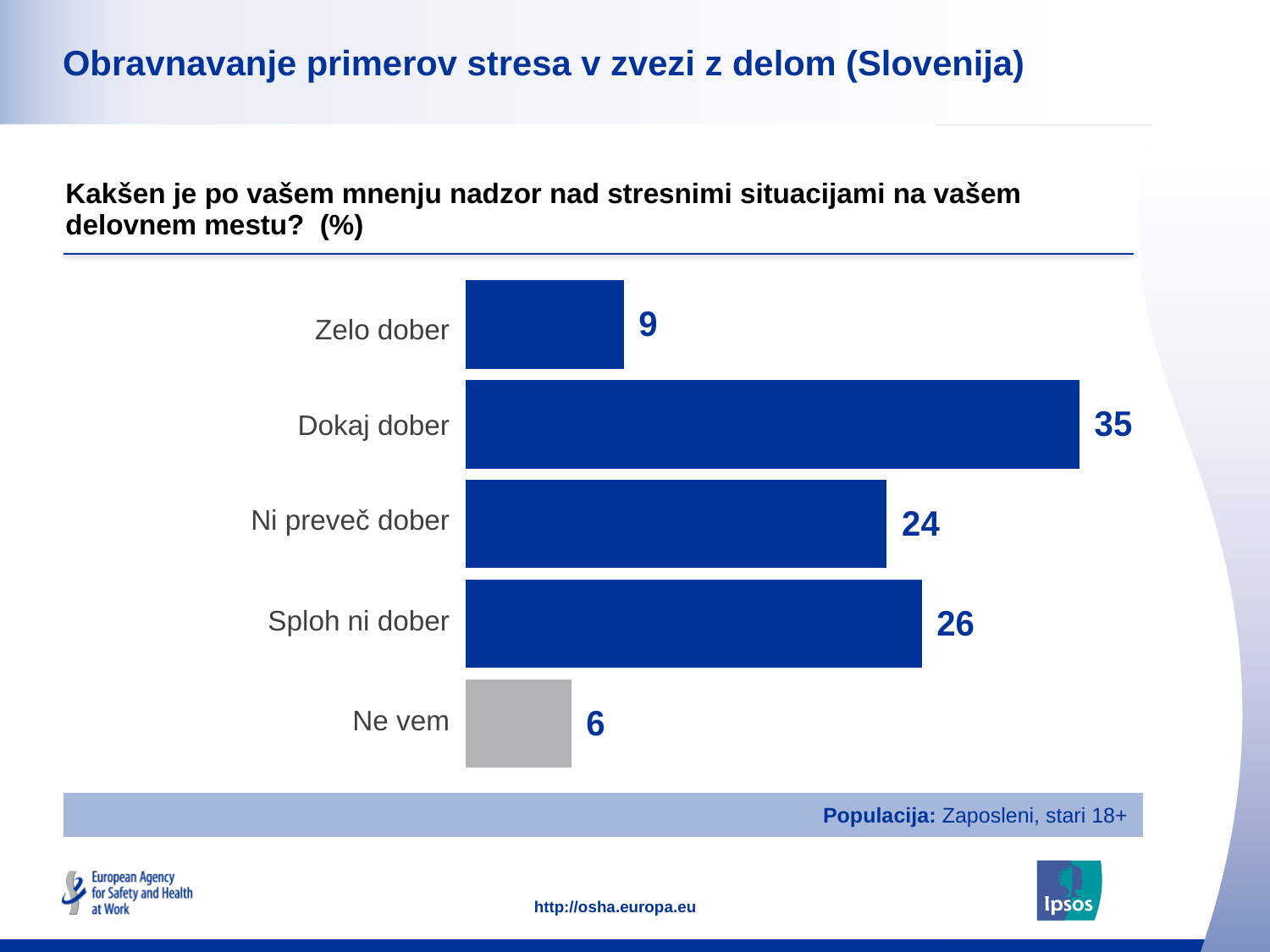
What is the total of the values for "Zelo dober" and "Dokaj dober"? 44 How many categories are shown in the chart? 5 What is the value for "Dokaj dober"? 35 Which category has the lowest value? Ne vem What kind of chart is shown on the slide? Bar chart Which category has the highest value? Dokaj dober What is the value for "Sploh ni dober"? 26 What is the difference between the values for "Dokaj dober" and "Ni preveč dober"? 11 Which bar is shown in grey rather than blue? Ne vem Which is larger, the value for "Sploh ni dober" or the value for "Ni preveč dober"? Sploh ni dober What is the value for "Zelo dober"? 9 What is the value for "Ne vem"? 6